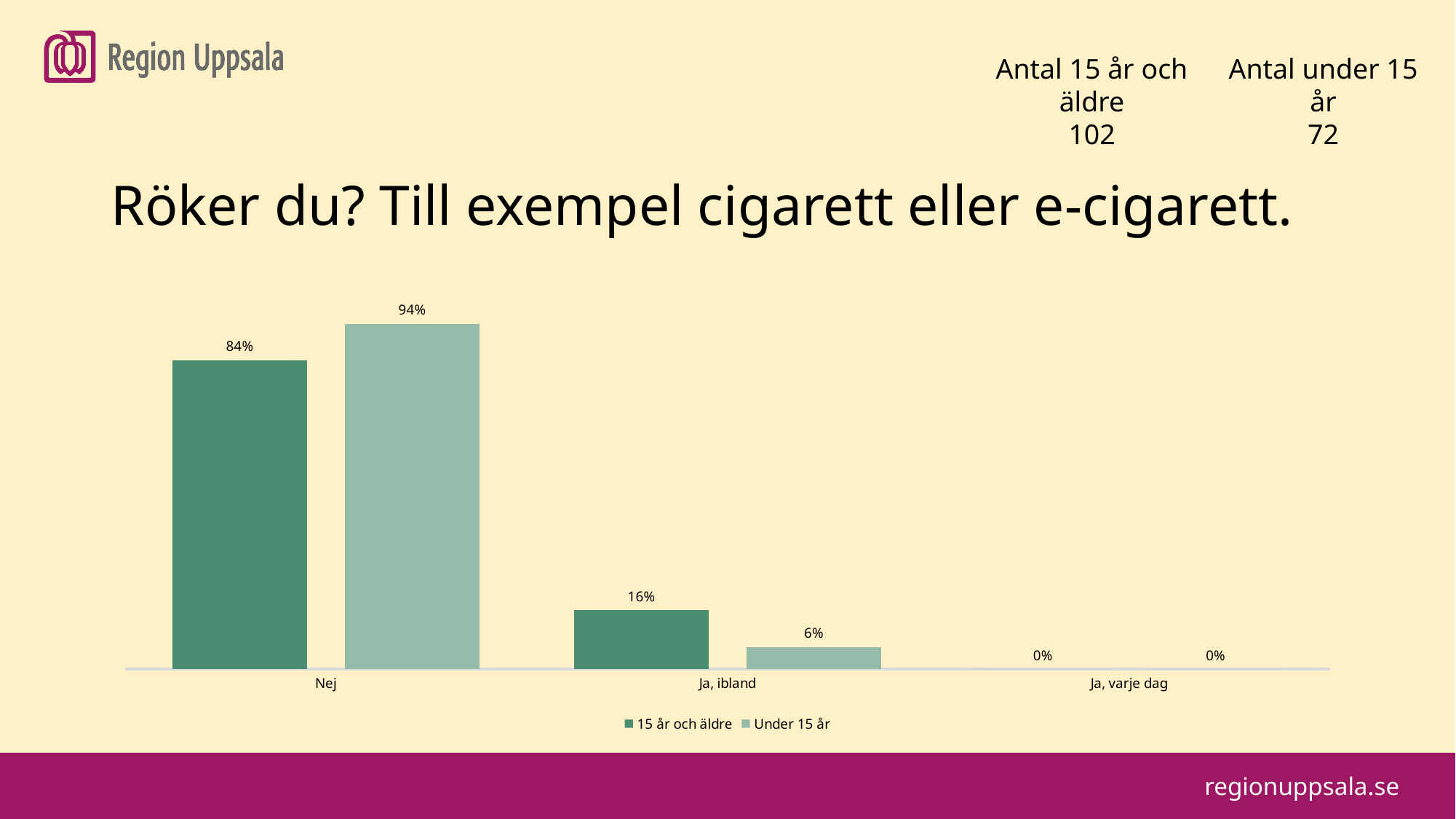
How many series does the legend list? 2 What is the value for "Ja, varje dag" in the "Under 15 år" series? 0% For "Ja, ibland", which series has the larger value: "15 år och äldre" or "Under 15 år"? 15 år och äldre What is the value for "Nej" in the "15 år och äldre" series? 84% Which category has the lowest value in the "15 år och äldre" series? Ja, varje dag Which category has the highest value in the "Under 15 år" series? Nej What is the value for "Ja, ibland" in the "15 år och äldre" series? 16% What kind of chart is shown on the slide? Bar chart What is the value for "Nej" in the "Under 15 år" series? 94% What is the value for "Ja, ibland" in the "Under 15 år" series? 6% How many categories are shown on the x axis? 3 What is the difference between the "Under 15 år" and "15 år och äldre" values for "Nej"? 10%